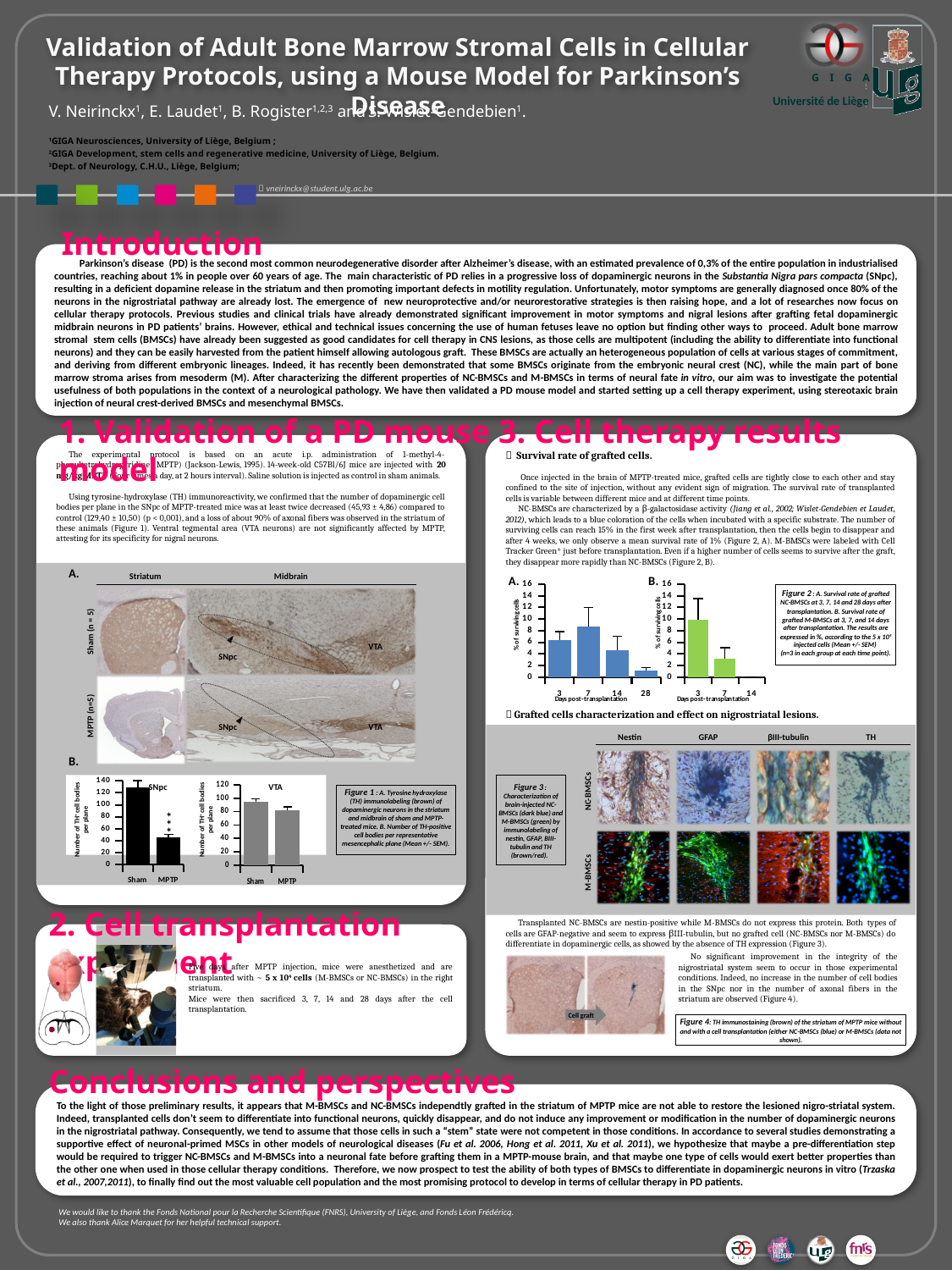
In Figure 2B, is the value at 3 days post-transplantation greater or less than 8? greater In Figure 2B (survival of grafted M-BMSCs), at which day post-transplantation is the percentage of surviving cells highest? 3 In the SNpc chart of Figure 1B, which group has the higher number of TH+ cell bodies per plane, Sham or MPTP? Sham In Figure 1B, what kind of chart is used to show the number of TH+ cell bodies per plane? bar chart In the SNpc chart of Figure 1B, is the value for Sham greater or less than 100? greater In the VTA chart of Figure 1B, is the value for MPTP greater or less than 60? greater In Figure 2A (survival of grafted NC-BMSCs), at which day post-transplantation is the percentage of surviving cells lowest? 28 In Figure 2A (survival of grafted NC-BMSCs), at which day post-transplantation is the percentage of surviving cells highest? 7 How many time points are plotted in Figure 2A? 4 How many groups are compared in the VTA chart of Figure 1B? 2